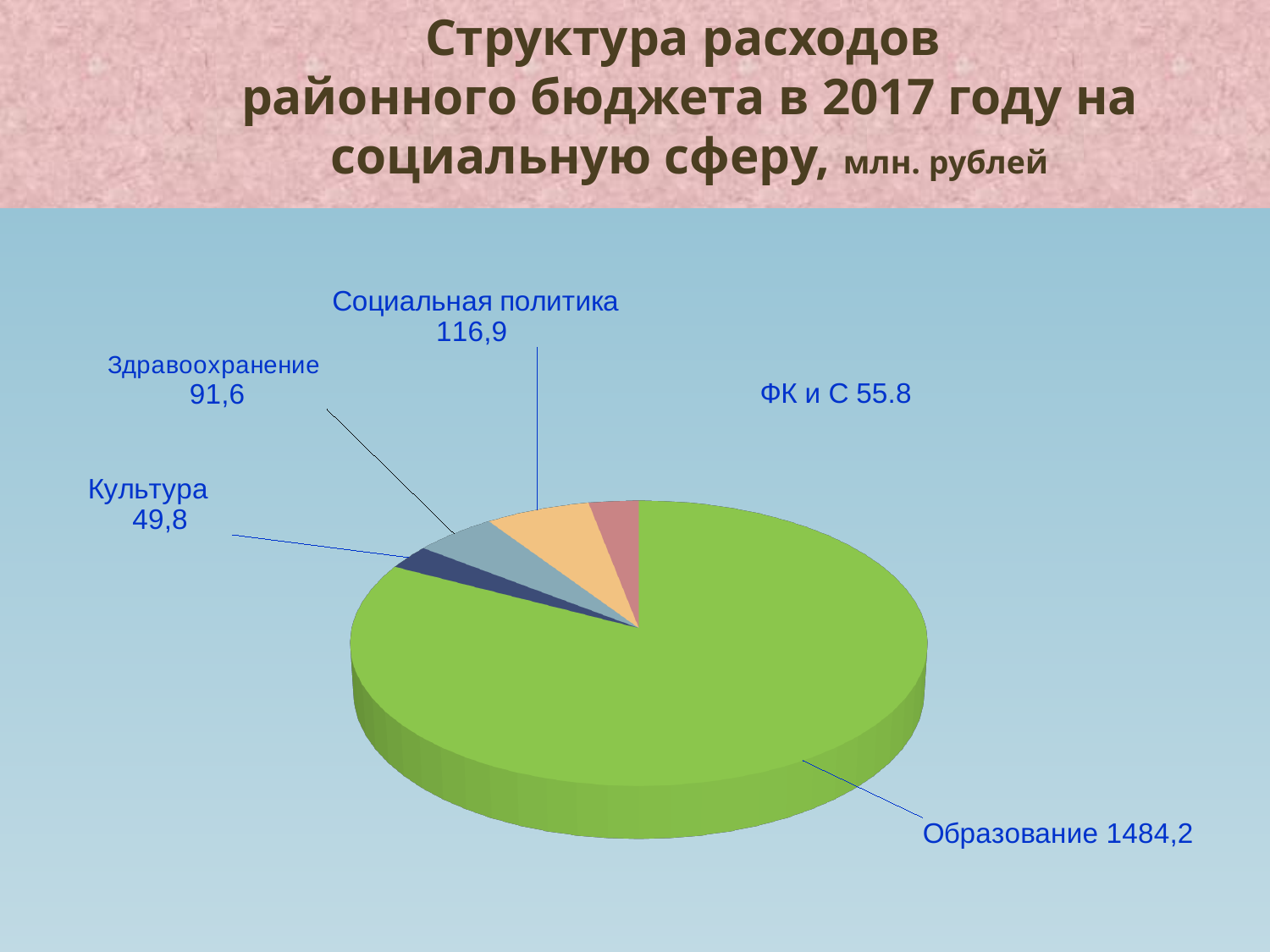
Which is larger, the value for ФК и С or the value for Культура? ФК и С What is the value for Культура? 49,8 What is the value for Образование? 1484,2 What colour is the Образование slice? Green How many slices does the pie chart have? 5 What unit is stated in the chart title? млн. рублей What is the difference between the values for Социальная политика and Здравоохранение? 25,3 What is the value for Здравоохранение? 91,6 Which category has the smallest value? Культура Which category has the largest slice of the pie? Образование What type of chart is shown on the slide? Pie chart What is the value for Социальная политика? 116,9